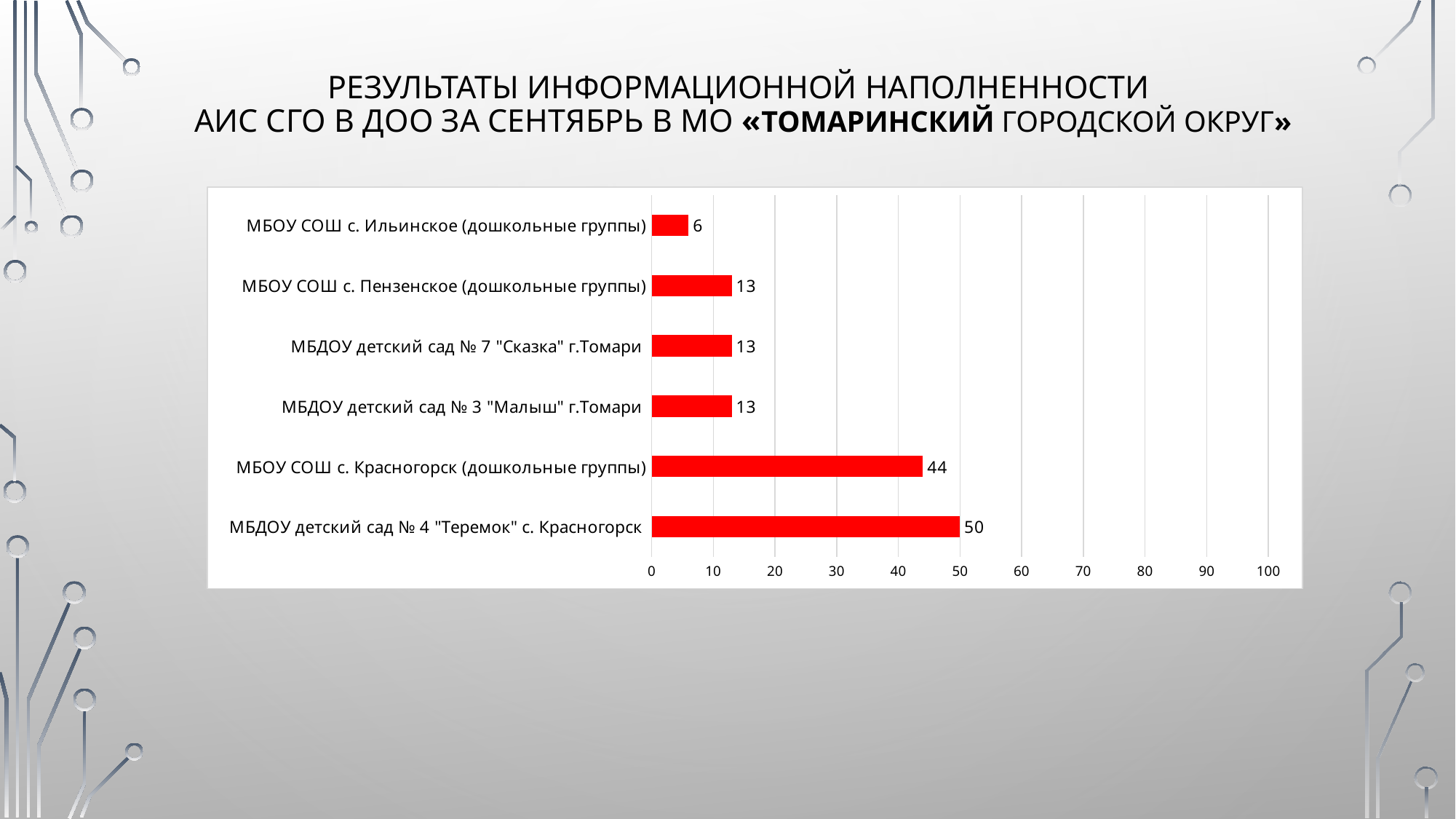
What is the value for МБОУ СОШ с. Красногорск (дошкольные группы)? 44 What kind of chart is shown on the slide? Bar chart Which category has the highest value? МБДОУ детский сад № 4 "Теремок" с. Красногорск What is the value for МБДОУ детский сад № 4 "Теремок" с. Красногорск? 50 What is the difference between the values for МБДОУ детский сад № 4 "Теремок" с. Красногорск and МБОУ СОШ с. Красногорск (дошкольные группы)? 6 What is the difference between the values for МБОУ СОШ с. Пензенское (дошкольные группы) and МБОУ СОШ с. Ильинское (дошкольные группы)? 7 How many categories are shown in the chart? 6 What is the maximum value shown on the horizontal axis? 100 Which category has the lowest value? МБОУ СОШ с. Ильинское (дошкольные группы) What is the value for МБОУ СОШ с. Ильинское (дошкольные группы)? 6 What is the value for МБДОУ детский сад № 7 "Сказка" г.Томари? 13 Which is larger: the value for МБОУ СОШ с. Красногорск (дошкольные группы) or the value for МБДОУ детский сад № 3 "Малыш" г.Томари? МБОУ СОШ с. Красногорск (дошкольные группы)